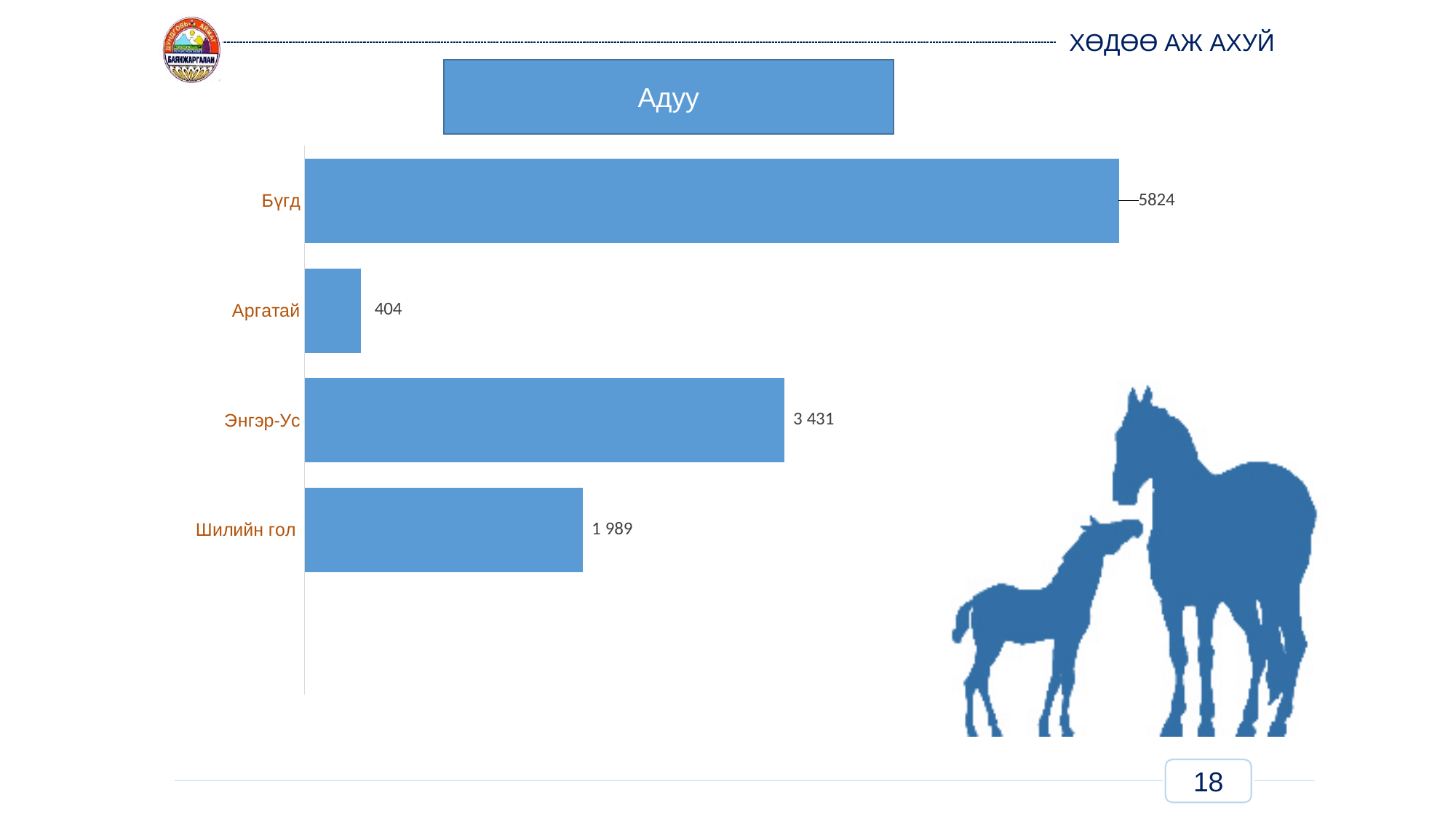
What is the difference between the values for Энгэр-Ус and Шилийн гол? 1 442 What is the value shown for Бүгд? 5824 Which category has the highest value? Бүгд What kind of chart is shown on the slide? Bar chart How many categories are shown in the chart? 4 What is the value shown for Аргатай? 404 What is the title of the chart? Адуу Which is larger, the value for Энгэр-Ус or the value for Шилийн гол? Энгэр-Ус What is the value shown for Энгэр-Ус? 3 431 What is the difference between the values for Шилийн гол and Аргатай? 1 585 Which category has the lowest value? Аргатай What is the value shown for Шилийн гол? 1 989